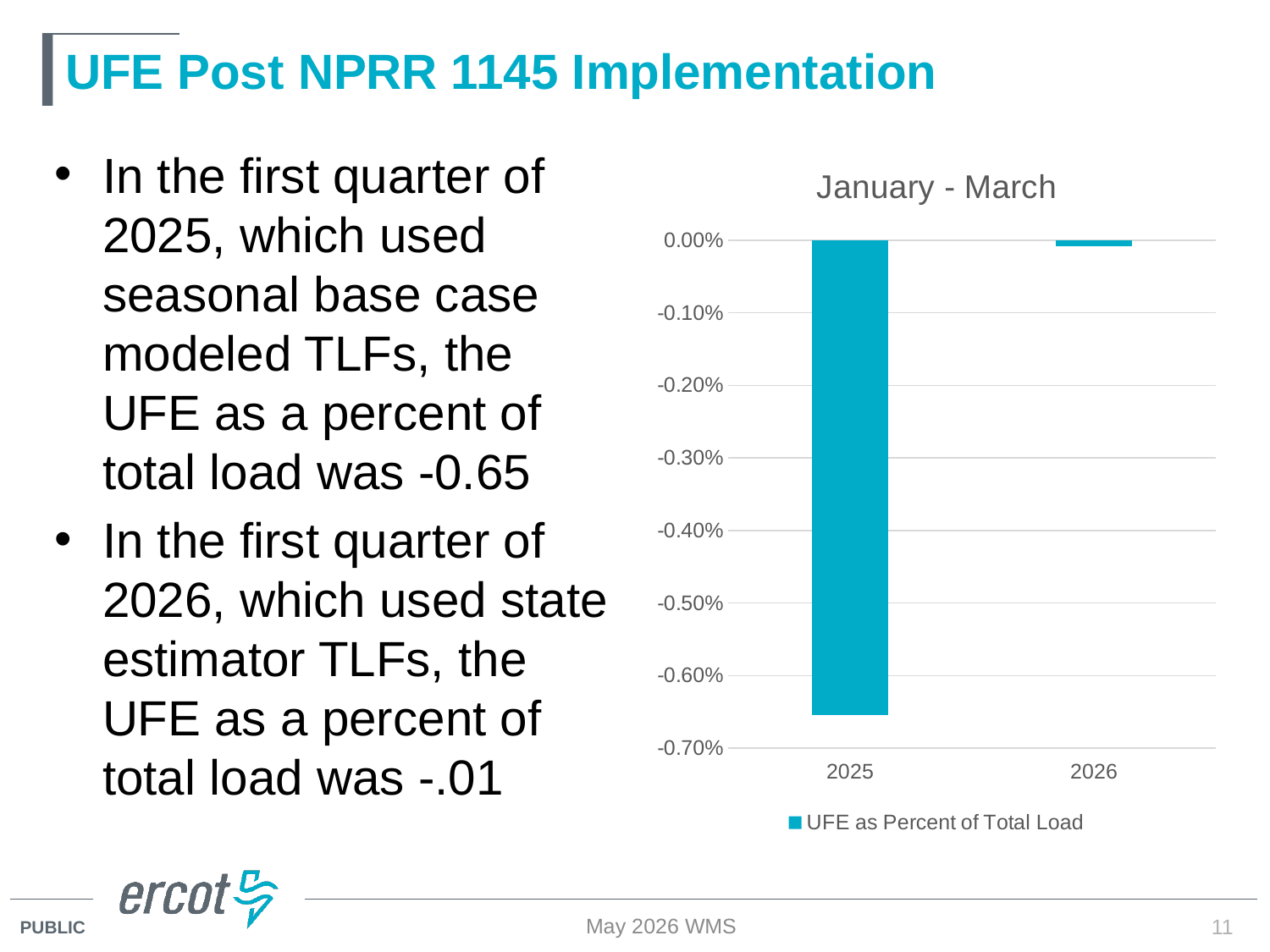
Is the value for 2025 greater or less than -0.70%? greater Do the values rise or fall from 2025 to 2026 along the x axis? rise What is the title of the chart? January - March Which year has the highest UFE as Percent of Total Load in the chart? 2026 How many categories are shown on the x axis of the chart? 2 Is the value for 2026 greater or less than -0.10%? greater Which is larger, the value for 2025 or the value for 2026? 2026 How many series does the chart legend list? 1 Which year has the lowest (most negative) UFE as Percent of Total Load in the chart? 2025 What series name is shown in the chart legend? UFE as Percent of Total Load Is the value for 2025 greater or less than -0.60%? less What kind of chart is shown on the slide? bar chart